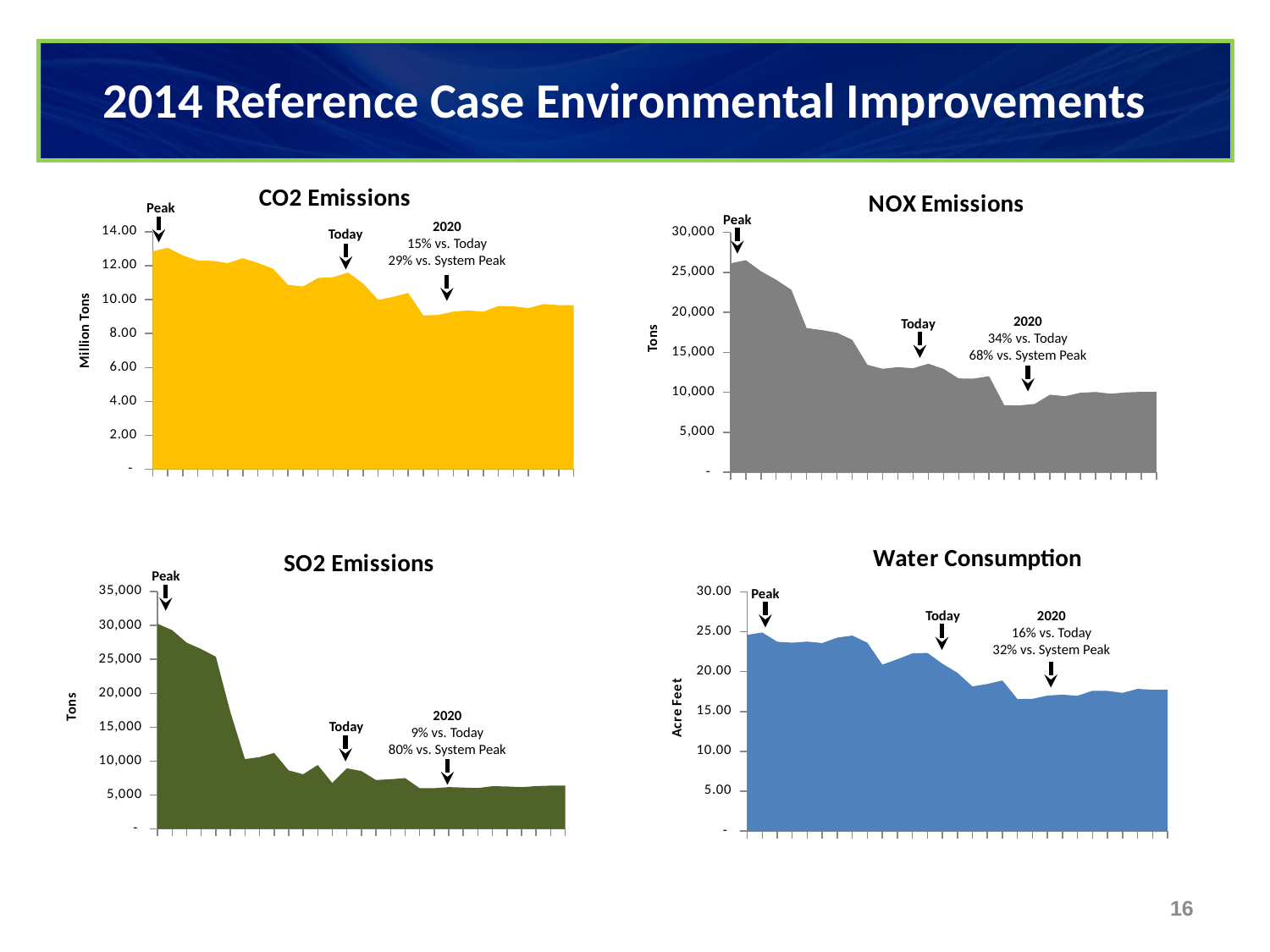
In the NOX Emissions chart, is the value at the right end of the series greater or less than 15,000? less In the NOX Emissions chart, is the value at the Peak greater or less than 25,000? greater In the NOX Emissions chart, what reduction vs. Today is shown for 2020? 34% In the CO2 Emissions chart, is the value at the Peak greater or less than 12.00? greater What is the y-axis label of the Water Consumption chart? Acre Feet What kind of chart is the CO2 Emissions chart? area chart In the SO2 Emissions chart, what reduction vs. System Peak is shown for 2020? 80% How many charts are shown on the slide? 4 In the CO2 Emissions chart, do the values generally rise or fall from left to right? fall